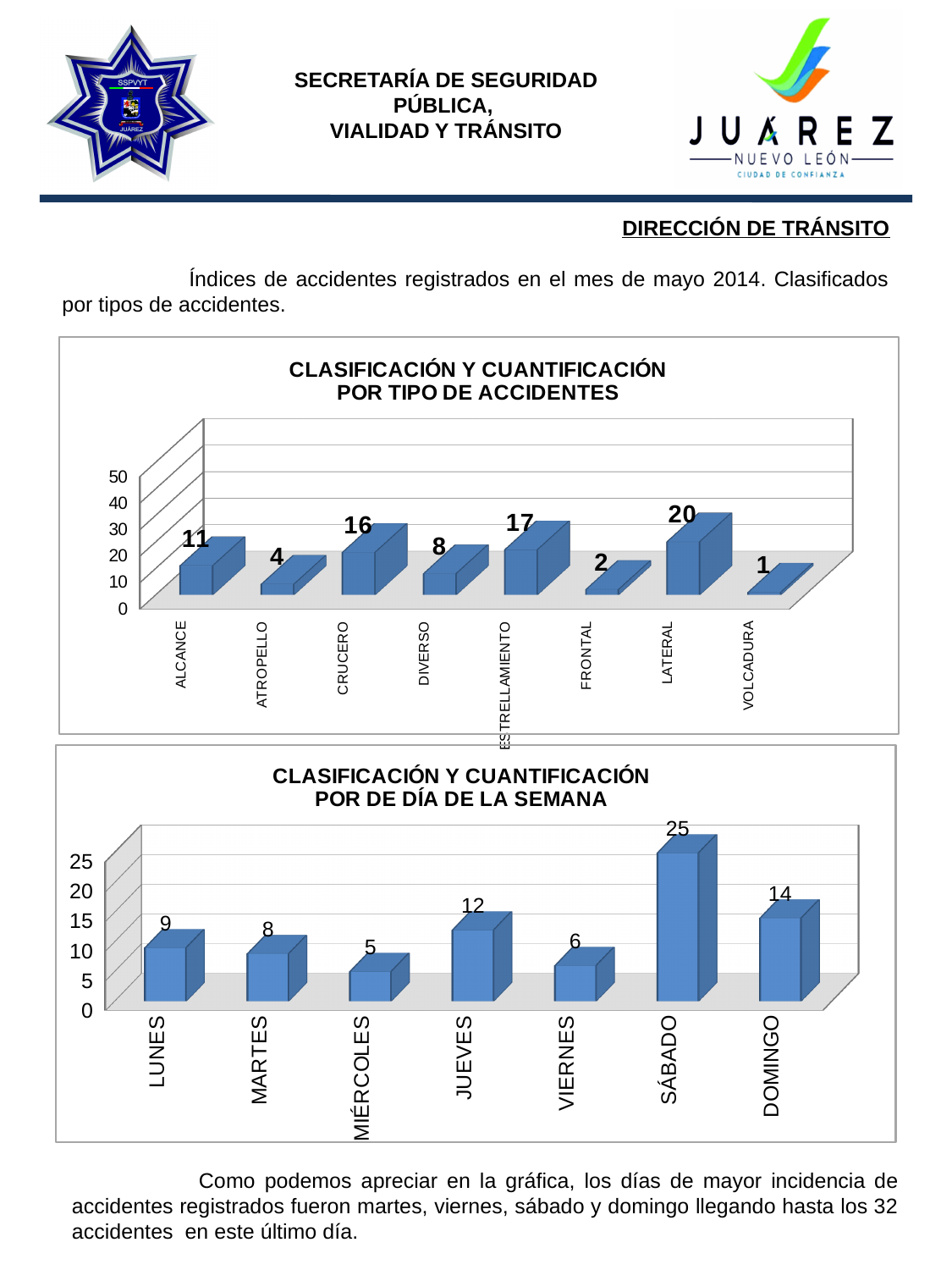
In the chart titled 'CLASIFICACIÓN Y CUANTIFICACIÓN POR TIPO DE ACCIDENTES', what is the value for CRUCERO? 16 In the chart titled 'CLASIFICACIÓN Y CUANTIFICACIÓN POR TIPO DE ACCIDENTES', how many accident types are shown? 8 In the chart titled 'CLASIFICACIÓN Y CUANTIFICACIÓN POR TIPO DE ACCIDENTES', what is the difference between the values for LATERAL and ALCANCE? 9 In the chart titled 'CLASIFICACIÓN Y CUANTIFICACIÓN POR TIPO DE ACCIDENTES', which is larger, ESTRELLAMIENTO or DIVERSO? ESTRELLAMIENTO In the chart titled 'CLASIFICACIÓN Y CUANTIFICACIÓN POR TIPO DE ACCIDENTES', which accident type has the lowest value? VOLCADURA In the chart titled 'CLASIFICACIÓN Y CUANTIFICACIÓN POR DE DÍA DE LA SEMANA', which day has the highest value? SÁBADO In the chart titled 'CLASIFICACIÓN Y CUANTIFICACIÓN POR DE DÍA DE LA SEMANA', what is the difference between the values for SÁBADO and DOMINGO? 11 In the chart titled 'CLASIFICACIÓN Y CUANTIFICACIÓN POR DE DÍA DE LA SEMANA', how many days are shown? 7 In the chart titled 'CLASIFICACIÓN Y CUANTIFICACIÓN POR DE DÍA DE LA SEMANA', what is the value for JUEVES? 12 In the chart titled 'CLASIFICACIÓN Y CUANTIFICACIÓN POR TIPO DE ACCIDENTES', which accident type has the highest value? LATERAL What kind of chart is the chart titled 'CLASIFICACIÓN Y CUANTIFICACIÓN POR DE DÍA DE LA SEMANA'? Bar chart In the chart titled 'CLASIFICACIÓN Y CUANTIFICACIÓN POR DE DÍA DE LA SEMANA', which day has the lowest value? MIÉRCOLES